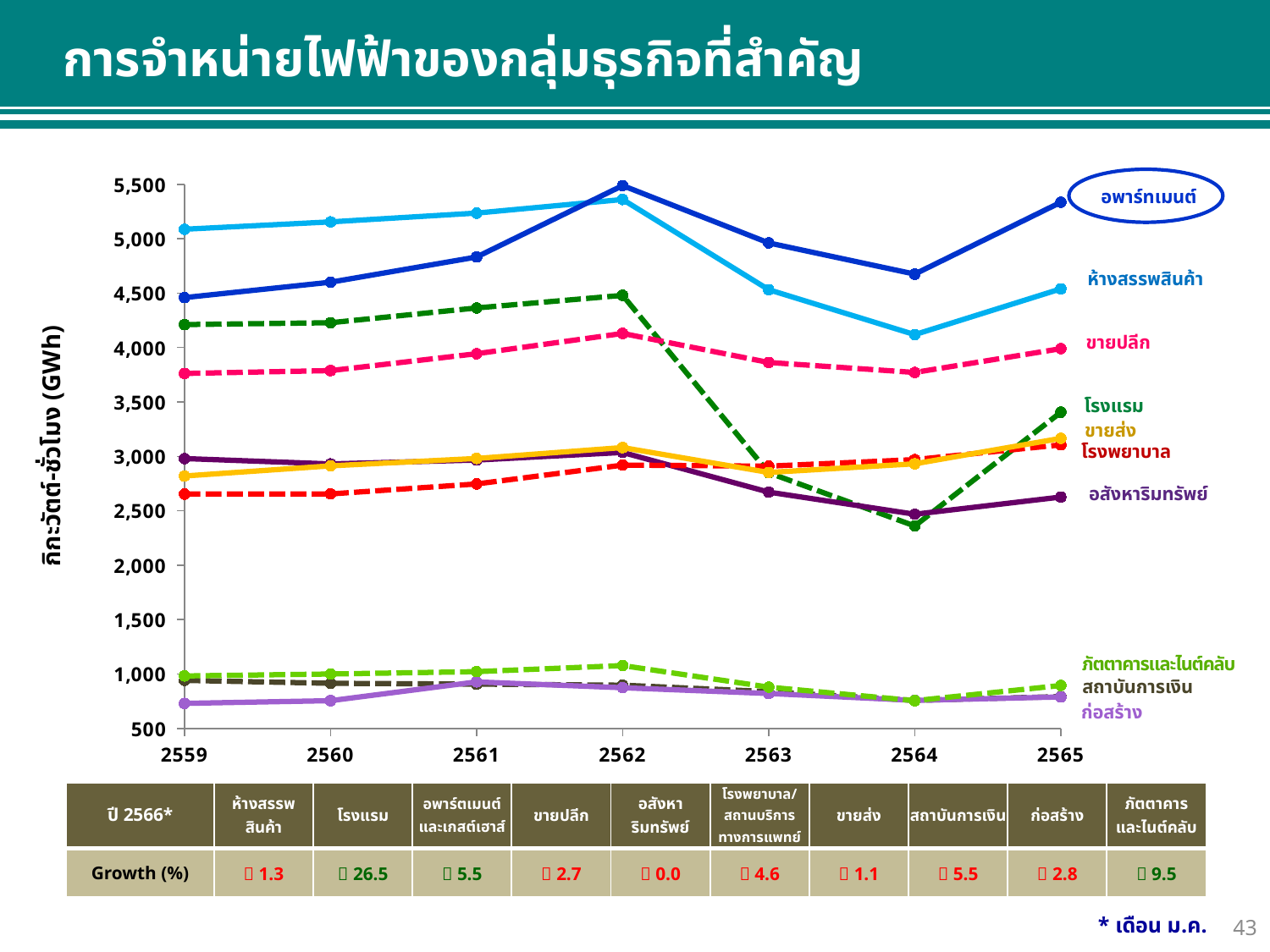
In 2559, which is larger: ห้างสรรพสินค้า or อพาร์ทเมนต์? ห้างสรรพสินค้า How many business-group series are labelled on the chart? 10 What kind of chart is shown on the slide? line chart How many years are plotted along the x axis of the chart? 7 Does the value for โรงแรม rise or fall from 2562 to 2564? fall In 2562, which is larger: อพาร์ทเมนต์ or ห้างสรรพสินค้า? อพาร์ทเมนต์ Which business group has the highest value in 2565? อพาร์ทเมนต์ Which business group has the lowest value in 2559? ก่อสร้าง Is the value for โรงแรม in 2564 greater or less than 2,500? less Is the value for ห้างสรรพสินค้า in 2559 greater or less than 5,000? greater What unit is shown on the y axis of the chart? กิกะวัตต์-ชั่วโมง (GWh) Is the value for ก่อสร้าง in 2559 greater or less than 1,000? less